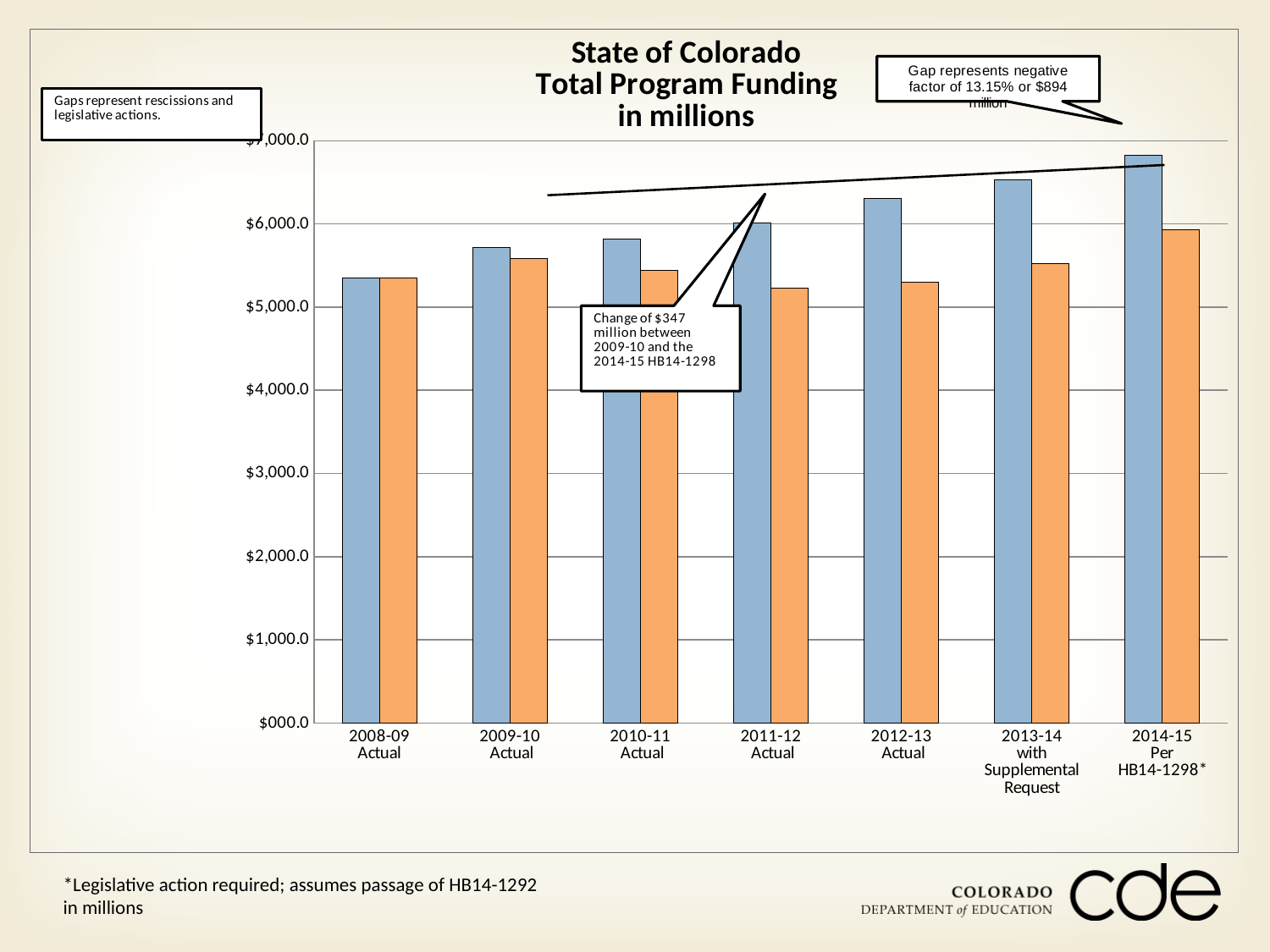
What kind of chart is shown on the slide? bar chart Is the blue bar for 2014-15 Per HB14-1298* greater or less than $6,000.0? greater What is the title of the chart? State of Colorado Total Program Funding in millions Which category has the highest blue bar? 2014-15 Per HB14-1298* How many fiscal-year categories are shown on the x axis? 7 Is the blue bar for 2008-09 Actual greater or less than $5,000.0? greater Is the orange bar for 2011-12 Actual greater or less than $6,000.0? less Which category has the lowest orange bar? 2011-12 Actual For 2013-14 with Supplemental Request, which bar is taller, the blue bar or the orange bar? the blue bar Which category has the lowest blue bar? 2008-09 Actual Do the blue bars rise or fall from 2008-09 Actual to 2014-15 Per HB14-1298*? rise